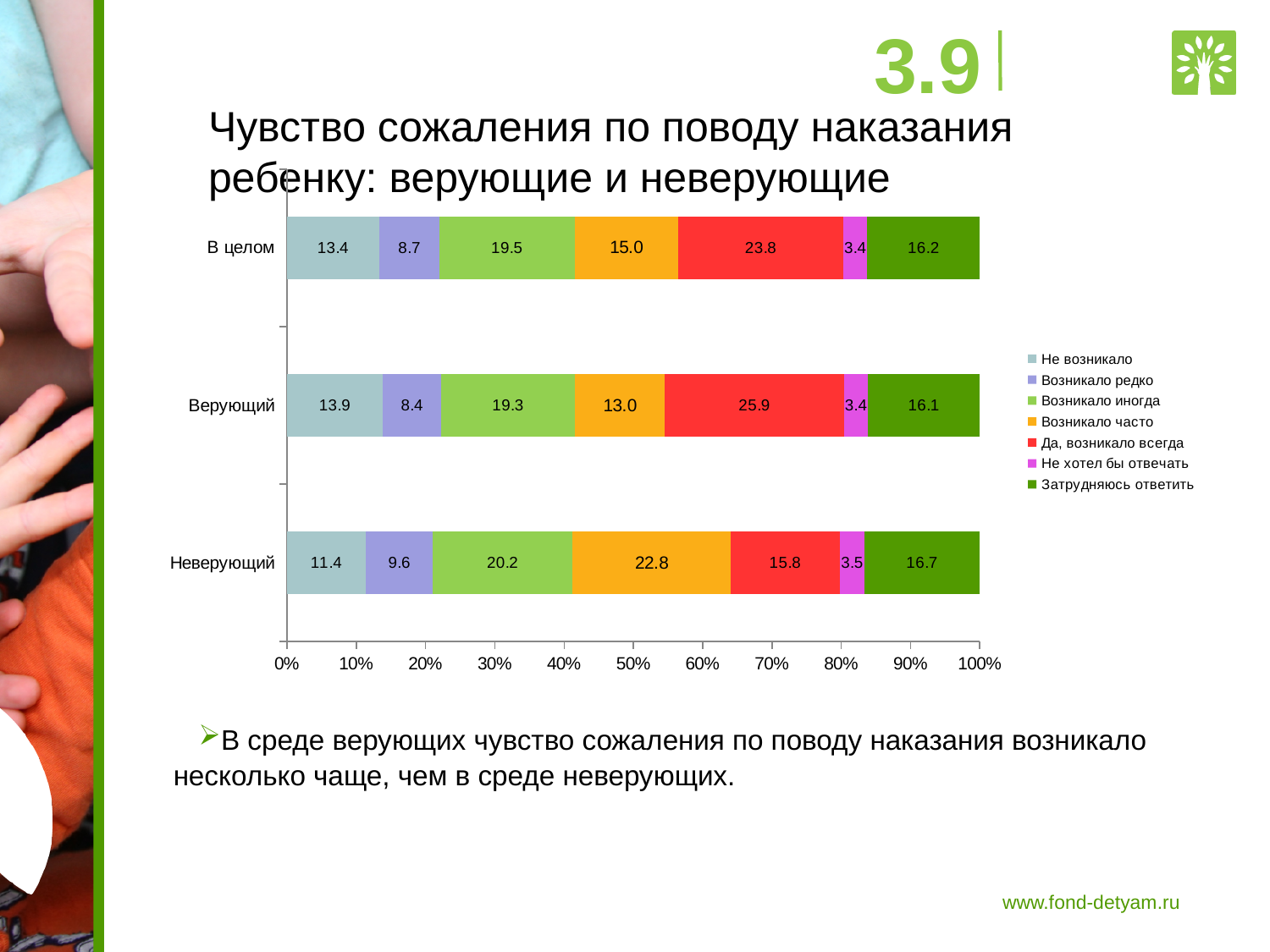
Which series has the smallest value in the "Верующий" bar? Не хотел бы отвечать What is the difference between the "Да, возникало всегда" values for "Верующий" and "Неверующий"? 10.1 What is the value for "Возникало часто" in the "Неверующий" bar? 22.8 Which series has the largest value in the "Неверующий" bar? Возникало часто How many series does the legend list? 7 What is the value for "Не возникало" in the "В целом" bar? 13.4 What kind of chart is shown on the slide? Stacked bar chart Which series is shown in red on the chart? Да, возникало всегда What is the value for "Да, возникало всегда" in the "Верующий" bar? 25.9 Which is larger: the "Возникало часто" value for "Верующий" or for "Неверующий"? Неверующий How many categories (bars) are shown on the chart? 3 What is the total of the "Неверующий" stacked bar? 100.0